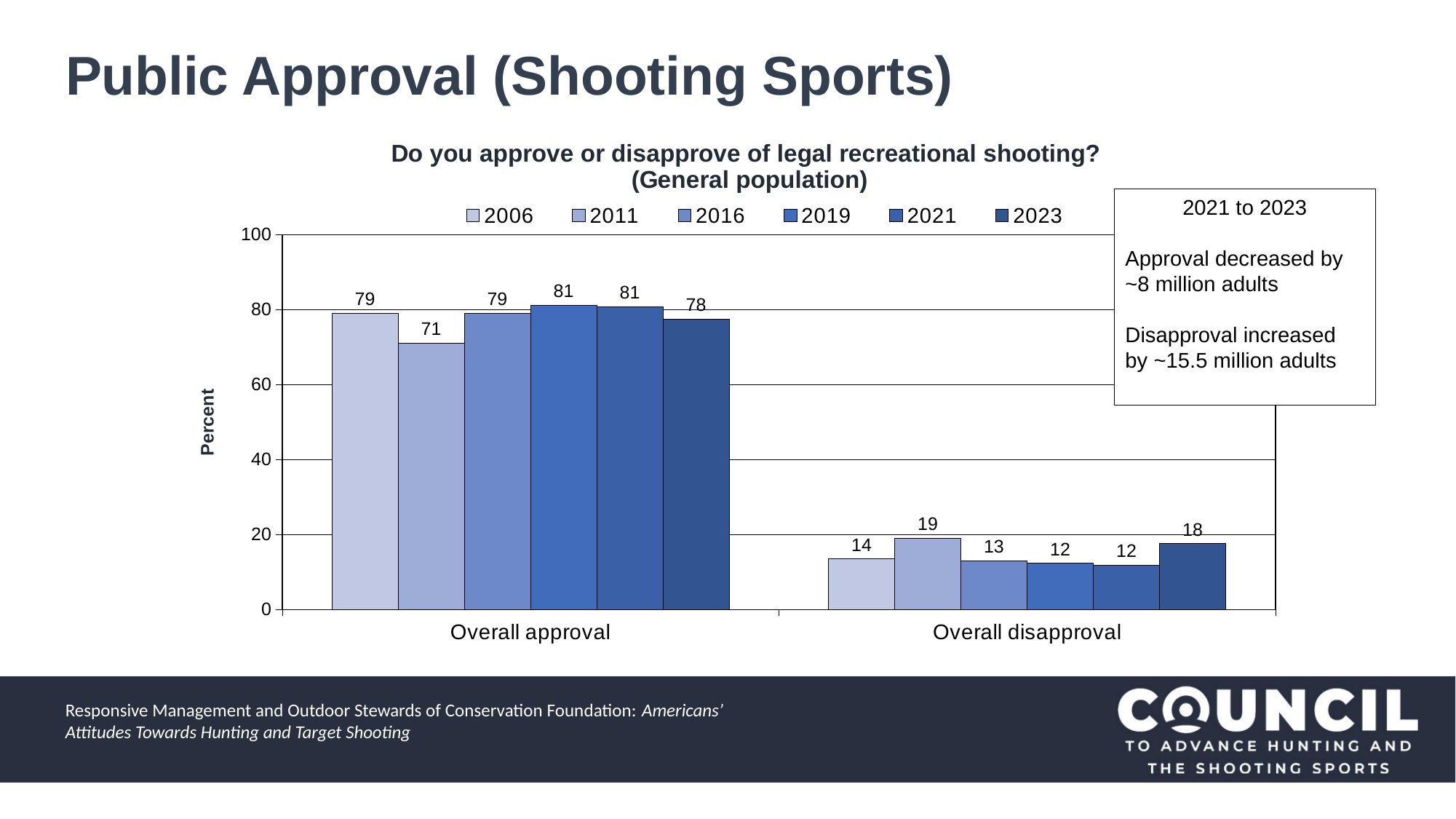
How many series does the legend list? 6 Which year has the lowest Overall approval value? 2011 What is the Overall disapproval value for 2023? 18 How many categories are shown on the x axis? 2 Which year has the highest Overall disapproval value? 2011 Which is larger, the Overall approval value for 2019 or for 2023? 2019 What is the Overall approval value for 2011? 71 What is the difference between the Overall approval values for 2006 and 2011? 8 What kind of chart is shown on the slide? Bar chart What is the Overall approval value for 2023? 78 What is the label of the y axis? Percent What is the difference between the Overall disapproval values for 2023 and 2021? 6